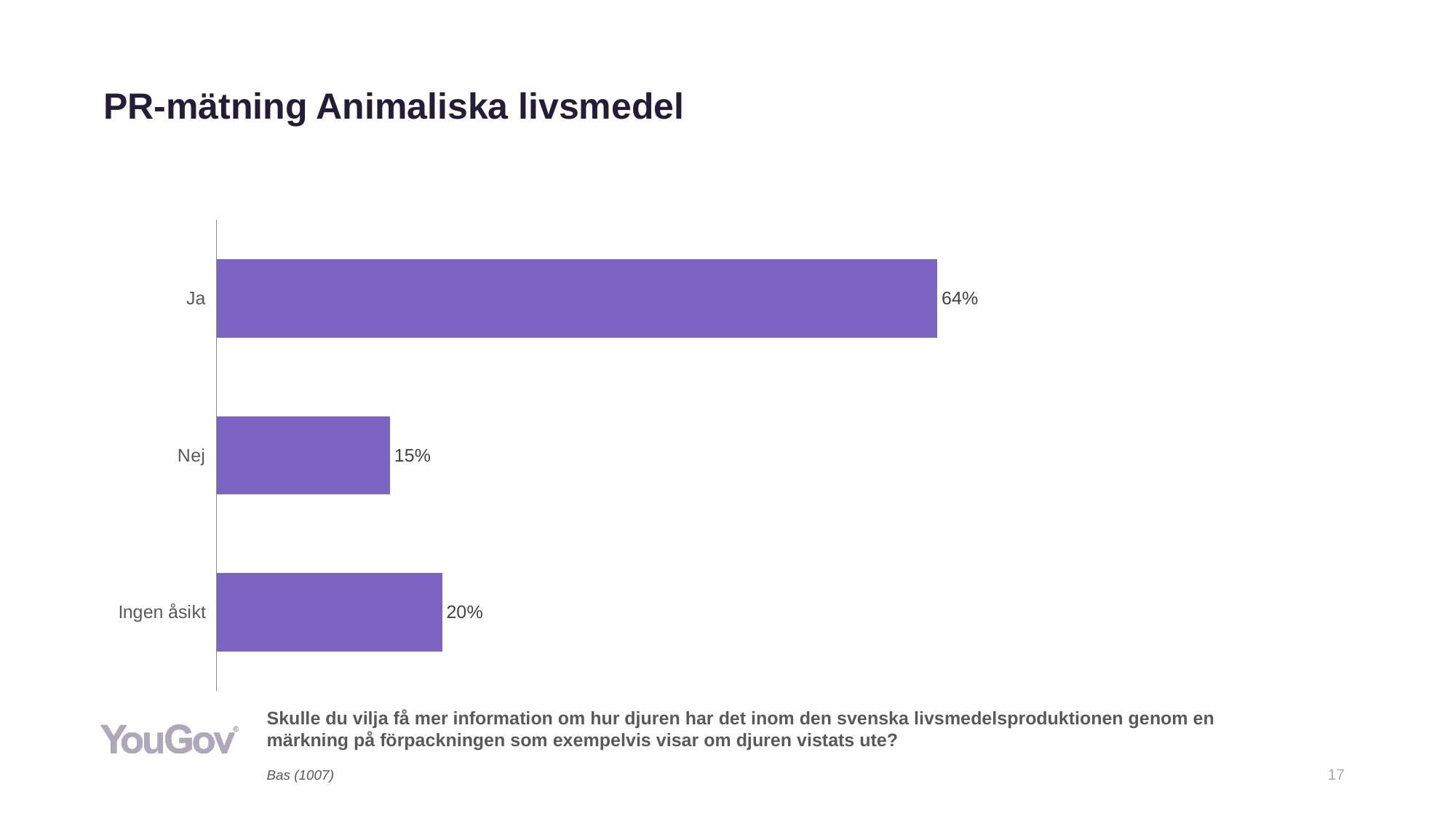
Which is larger, the value for Nej or the value for Ingen åsikt? Ingen åsikt What is the value for Nej? 15% How many categories are shown in the chart? 3 What is the difference between the values for Ingen åsikt and Nej? 5% What is the total of the three values shown in the chart? 99% What kind of chart is shown on the slide? Bar chart What colour are the bars in the chart? Purple Which category has the highest value? Ja What is the value for Ingen åsikt? 20% Which category has the lowest value? Nej What is the value for Ja? 64% What is the difference between the values for Ja and Nej? 49%